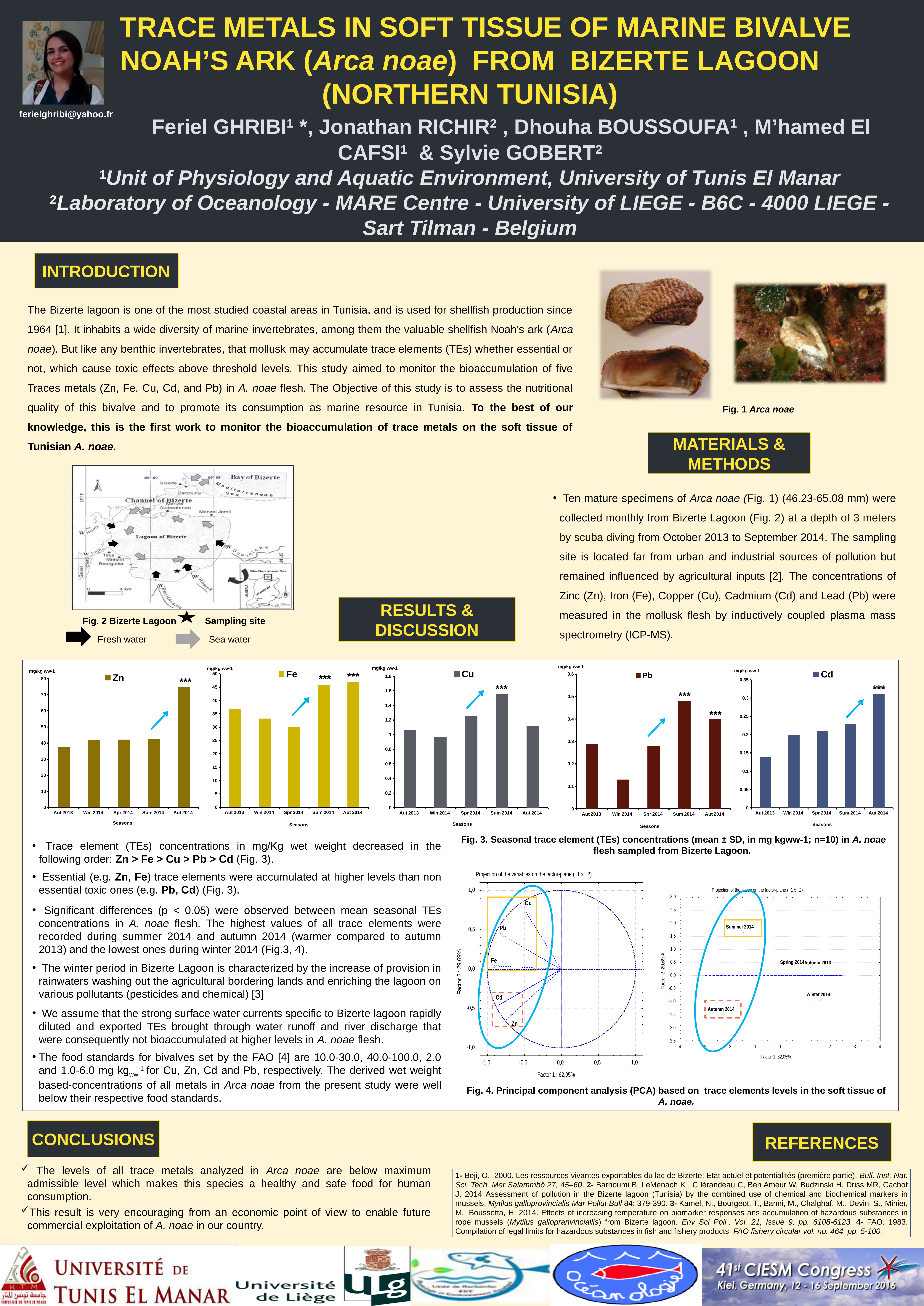
In the Pb chart, which is larger, the value for Sum 2014 or the value for Aut 2014? Sum 2014 In the Cu chart, which season has the highest Cu concentration? Sum 2014 In the Zn chart, is the value for Aut 2014 greater or less than 70? greater In the Zn chart, which season has the highest Zn concentration? Aut 2014 In the Pb chart, which season has the lowest Pb concentration? Win 2014 In the Cd chart, which season has the lowest Cd concentration? Aut 2013 In the Fe chart, is the value for Spr 2014 greater or less than 35? less What unit is shown on the y axis of the Cu chart? mg/kg ww-1 How many series does the legend of the Fe chart list? 1 How many seasons are plotted on the x axis of the Pb chart? 5 In the Cd chart, do the values rise or fall from Aut 2013 to Aut 2014? rise What kind of chart is the Zn chart in Fig. 3? bar chart